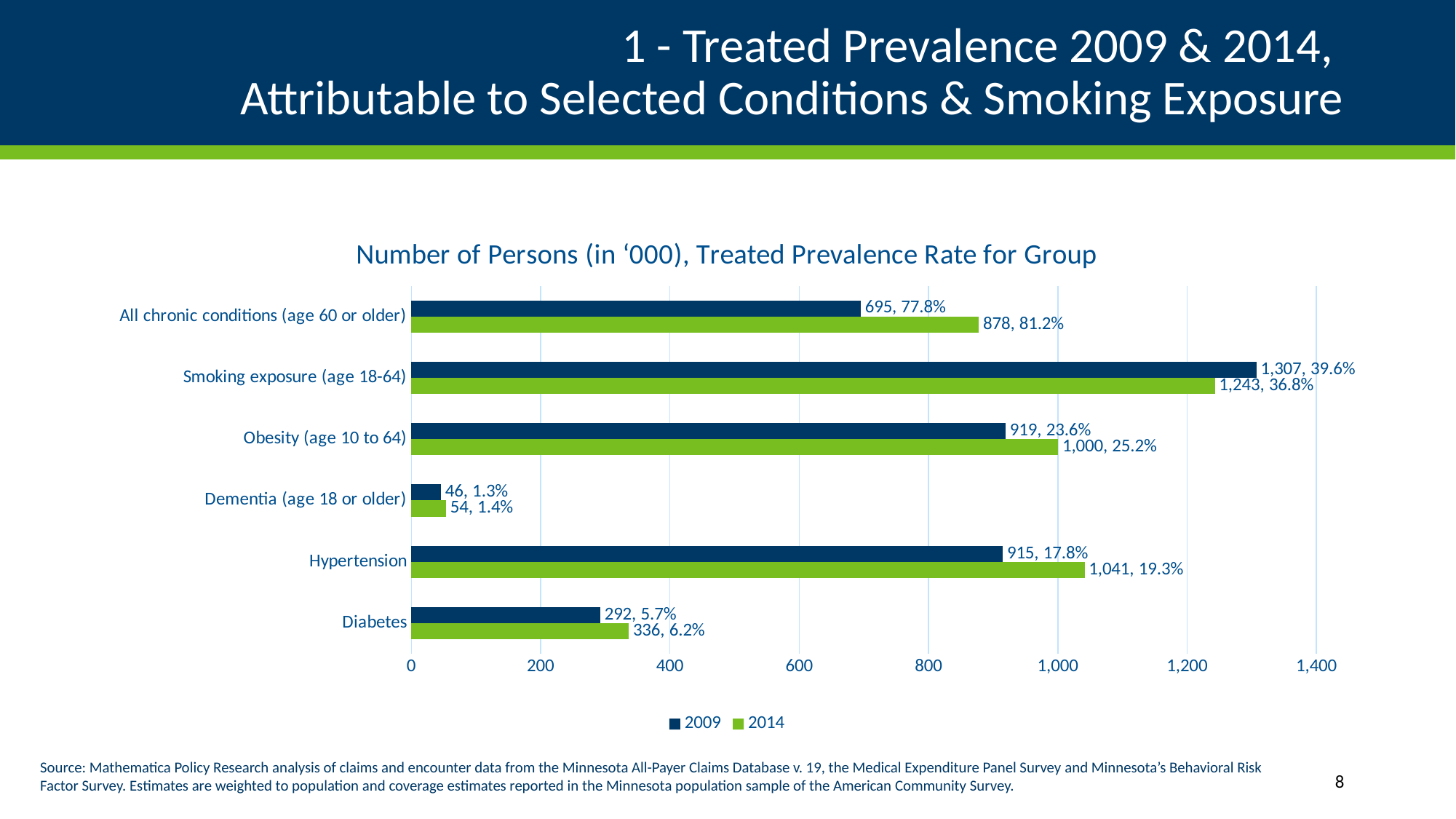
Which category has the highest number of persons in 2009? Smoking exposure (age 18-64) Which category has the lowest number of persons in 2014? Dementia (age 18 or older) What is the difference in number of persons (in '000) for Obesity (age 10 to 64) between 2014 and 2009? 81 How many series does the legend list? 2 What kind of chart is shown on the slide? Bar chart What is the number of persons (in '000) for Hypertension in 2014? 1,041 What is the number of persons (in '000) for Diabetes in 2009? 292 What is the treated prevalence rate for Dementia (age 18 or older) in 2014? 1.4% For Smoking exposure (age 18-64), which year has the larger number of persons, 2009 or 2014? 2009 How many categories are shown on the chart? 6 What is the treated prevalence rate for All chronic conditions (age 60 or older) in 2009? 77.8% Which colour represents the 2014 series in the chart? Green